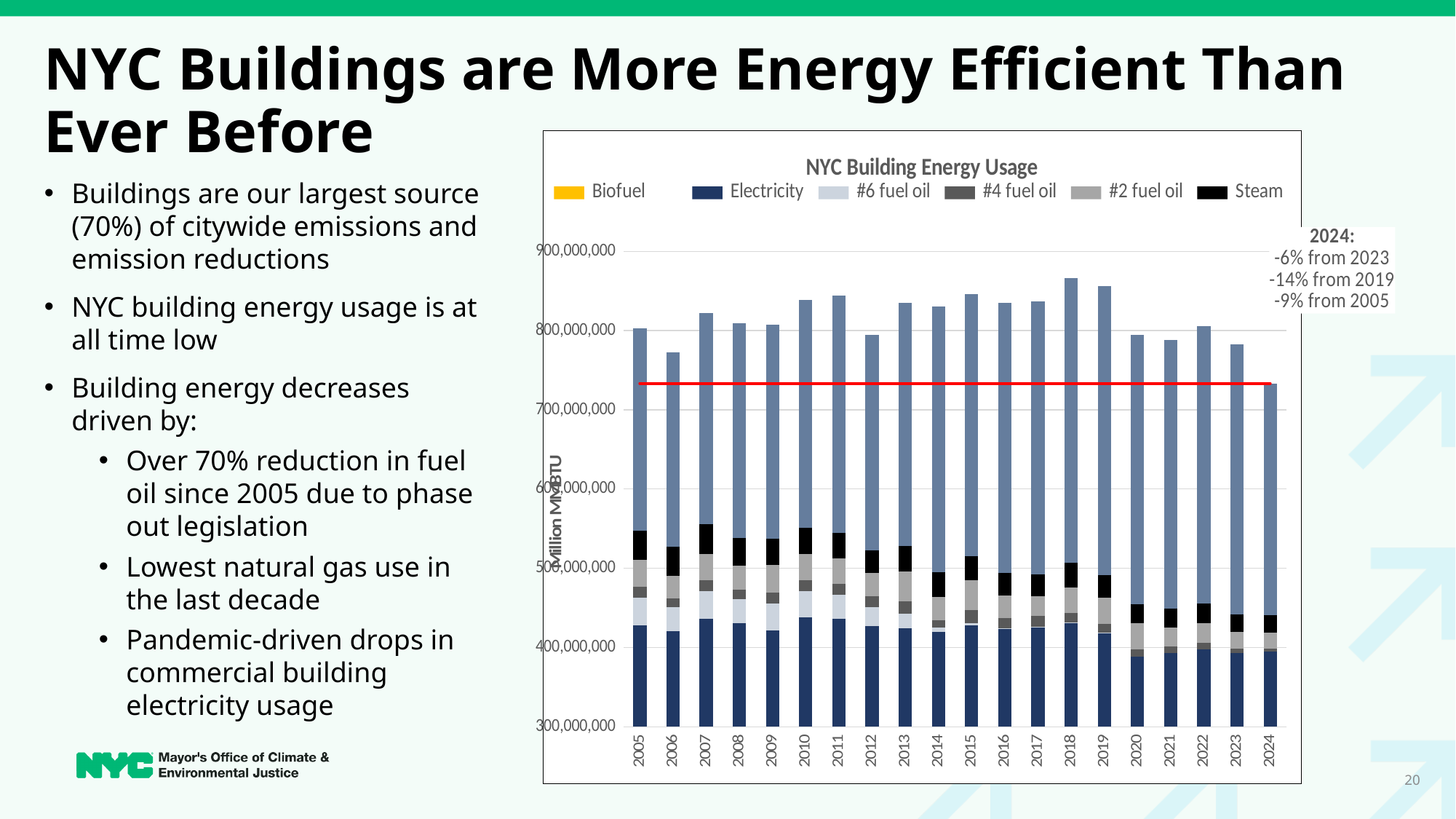
Which year has a larger total bar, 2018 or 2024? 2018 What type of chart is shown on the slide? Stacked bar chart How many series does the chart's legend list? 6 What is the title of the chart? NYC Building Energy Usage How many years are plotted along the x axis of the chart? 20 Is the total value for 2010 greater or less than 800,000,000? greater Which year has the tallest total bar in the chart? 2018 Is the total value for 2018 greater or less than 800,000,000? greater Do the total bars rise or fall from 2019 to 2024? fall Which year has the shortest total bar in the chart? 2024 Is the total value for 2024 greater or less than 800,000,000? less According to the annotation on the chart, by what percentage did 2024 change from 2019? -14%